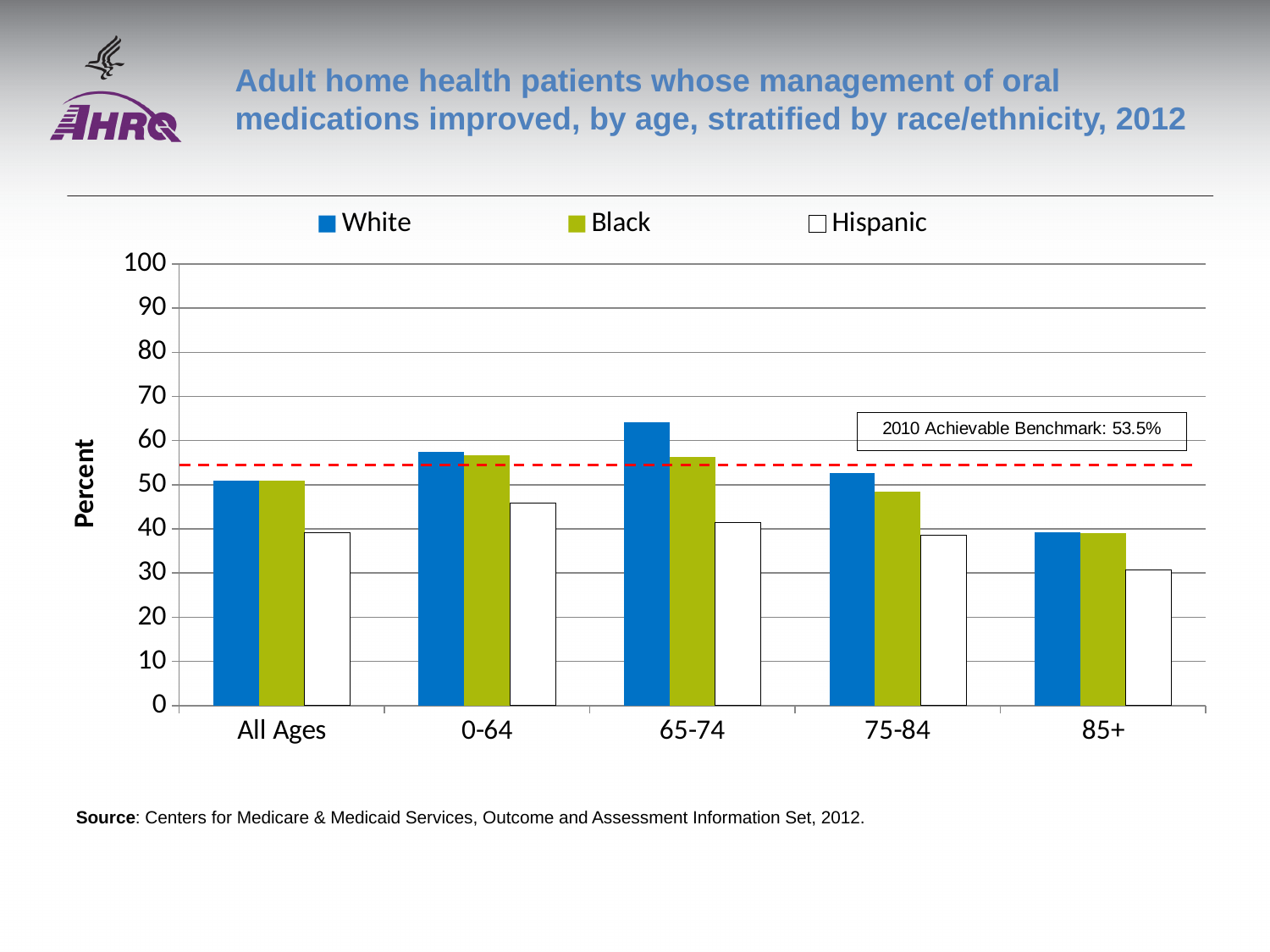
Is the value for White patients aged 65-74 greater or less than 60? greater For the 65-74 age group, which is larger: the value for White patients or the value for Hispanic patients? White For the 75-84 age group, which is larger: the value for Black patients or the value for Hispanic patients? Black Which age group has the highest value for White patients? 65-74 Is the value for Hispanic patients aged 85+ greater or less than 40? less How many series does the legend list? 3 What is the label on the y axis? Percent Is the value for Black patients aged 0-64 greater or less than 50? greater How many age categories are shown on the x axis? 5 What is the 2010 Achievable Benchmark shown on the chart? 53.5% Which age group has the lowest value for Hispanic patients? 85+ What kind of chart is shown on the slide? bar chart